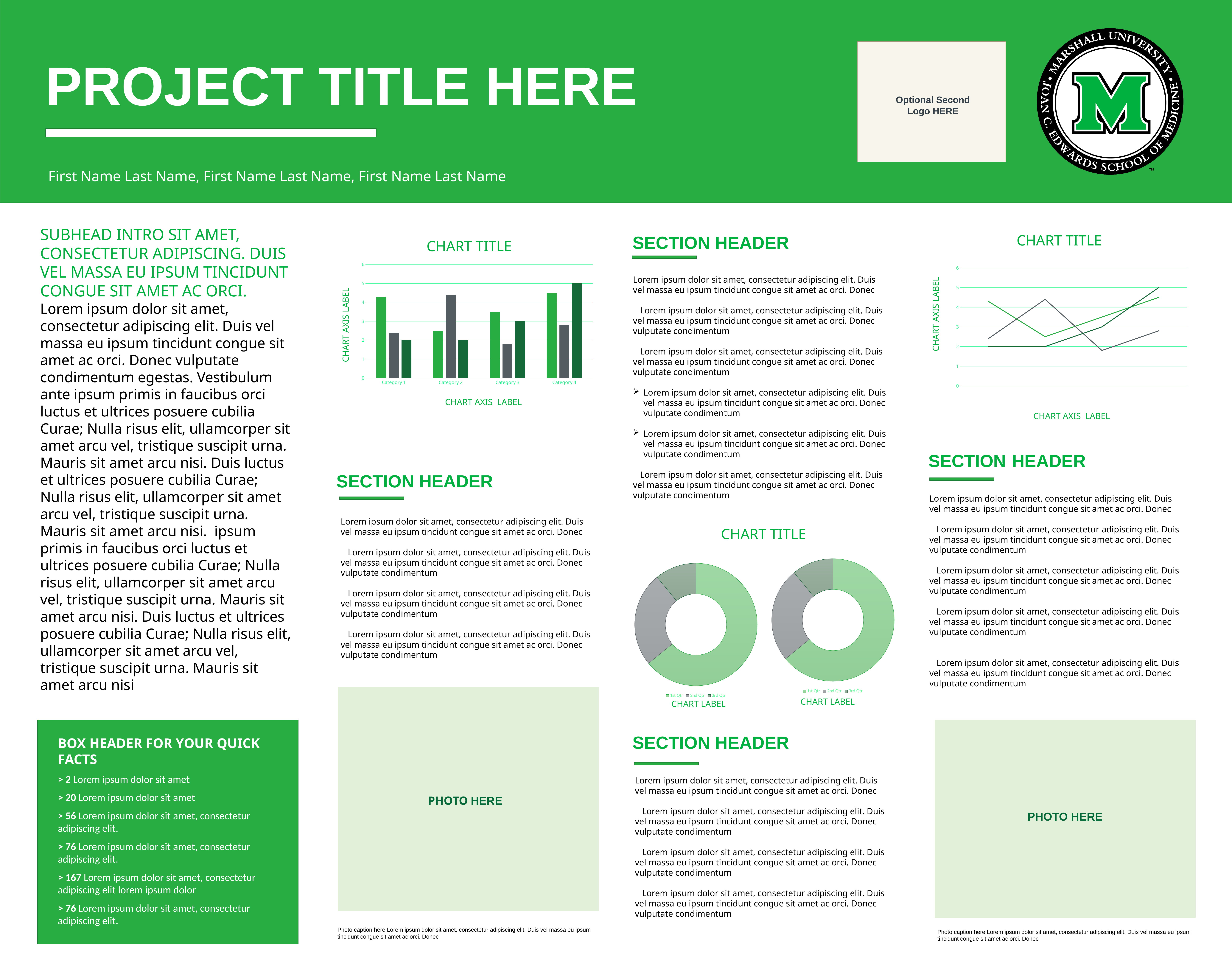
In the left donut chart in the center of the slide, which legend entry corresponds to the largest slice? 1st Qtr What kind of chart is the chart in the upper right of the slide? line chart In the bar chart in the upper left-center of the slide, what is the value of the dark green (rightmost) bar for Category 4? 5 In the bar chart in the upper left-center of the slide, which bar is tallest for Category 4: the light green, gray, or dark green bar? dark green In the bar chart in the upper left-center of the slide, how many bars are plotted for each category? 3 What kind of chart is the chart in the upper left-center of the slide (below the first 'CHART TITLE')? bar chart In the bar chart in the upper left-center of the slide, what is the value of the dark green (rightmost) bar for Category 3? 3 In the bar chart in the upper left-center of the slide, how many categories are shown on the x axis? 4 In the bar chart in the upper left-center of the slide, is the value of the gray (middle) bar for Category 3 greater or less than 3? less In the bar chart in the upper left-center of the slide, is the value of the light green (leftmost) bar for Category 1 greater or less than 3? greater In the bar chart in the upper left-center of the slide, which is larger for Category 2: the light green bar or the gray bar? the gray bar How many lines are plotted in the line chart in the upper right of the slide? 3